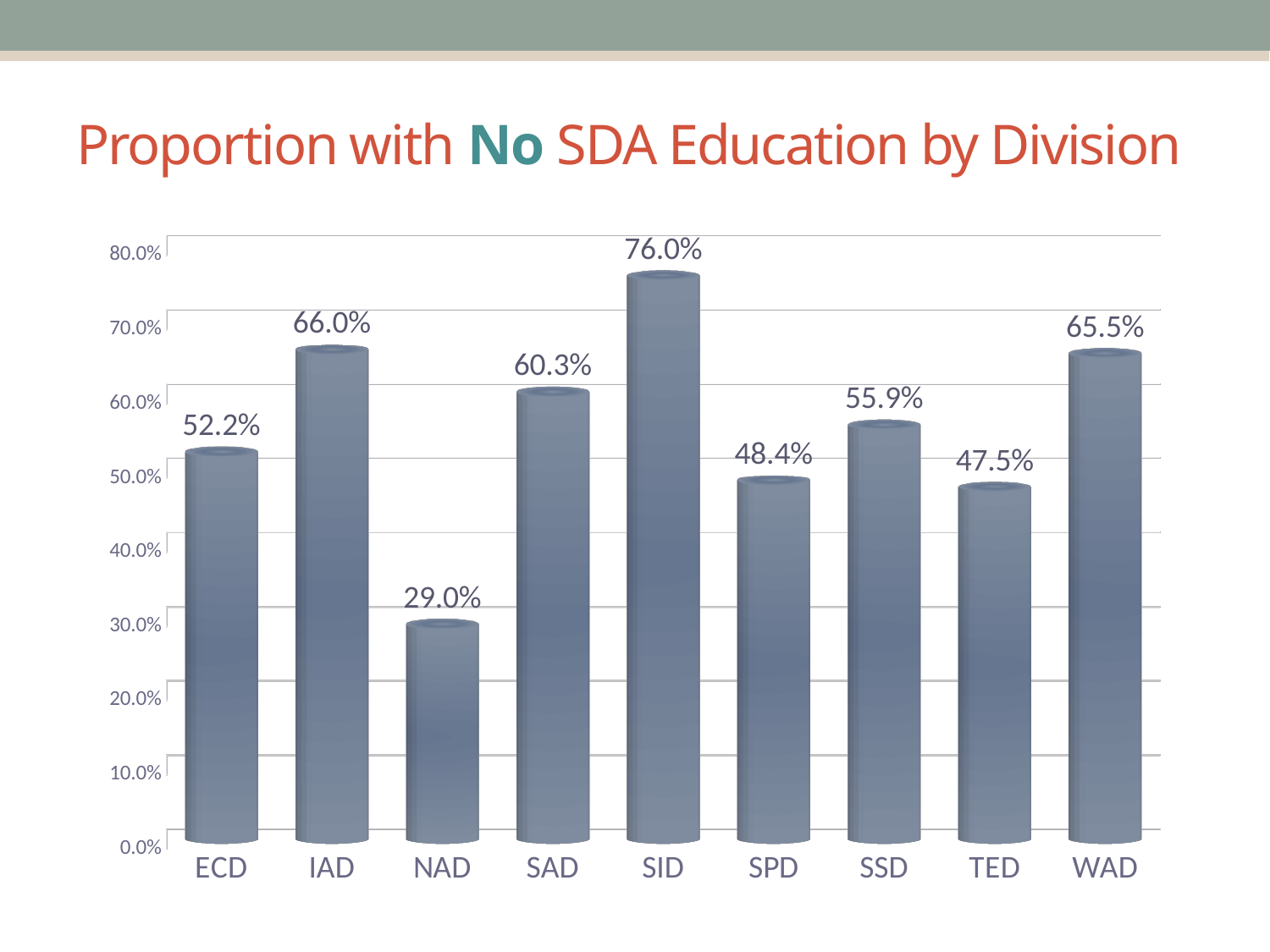
Which division has the highest proportion with no SDA education? SID What is the value for WAD? 65.5% Which is larger, the value for SSD or the value for SPD? SSD Which division has the lowest proportion with no SDA education? NAD What is the title of the slide? Proportion with No SDA Education by Division What is the difference between the values for SID and NAD? 47.0% How many divisions are shown on the chart? 9 What is the proportion with no SDA education for SAD? 60.3% What is the difference between the values for IAD and ECD? 13.8% What value is shown for TED? 47.5% What kind of chart is shown on the slide? bar chart Is the value for ECD greater or less than 50.0%? greater